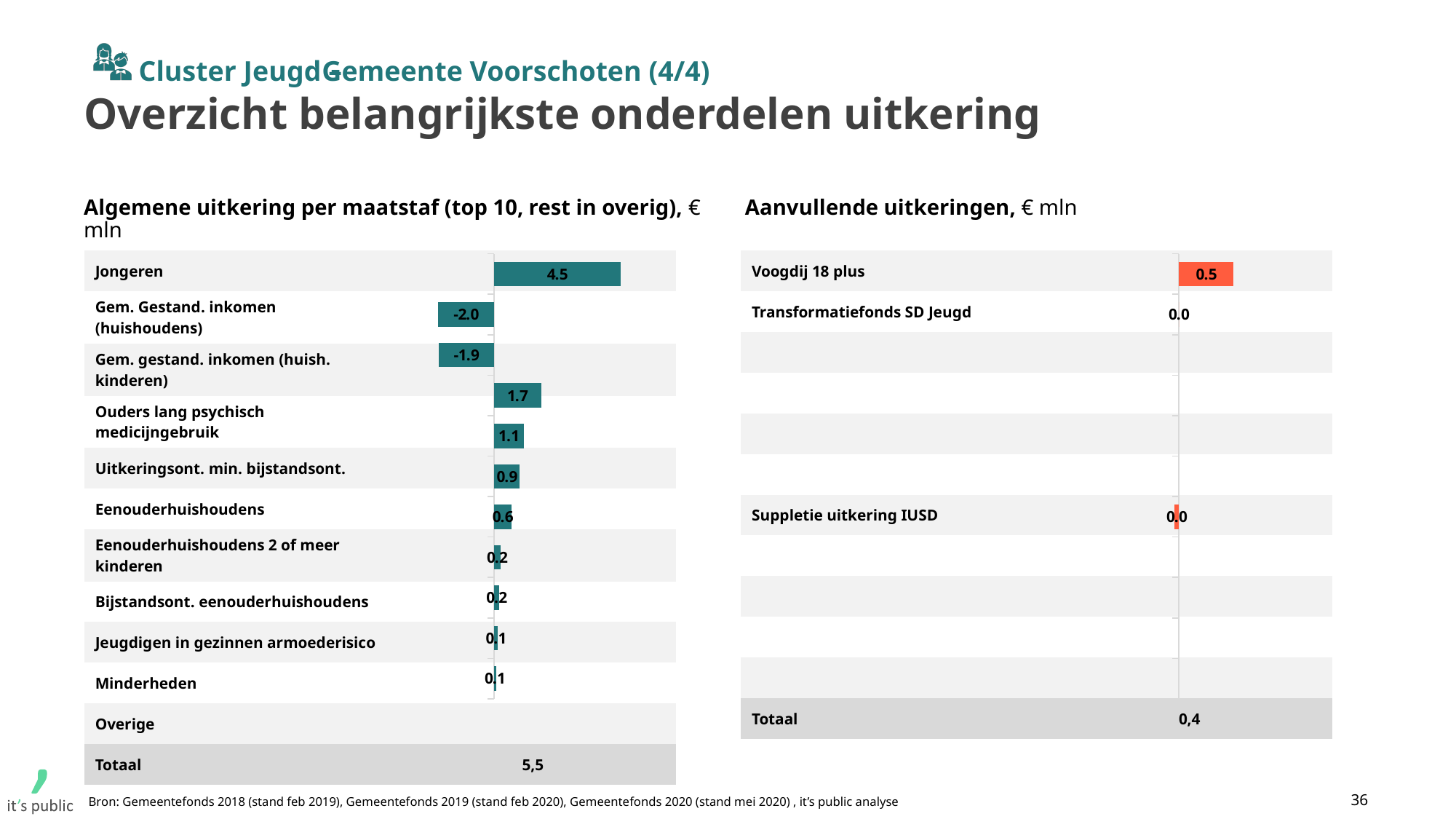
In the left chart 'Algemene uitkering per maatstaf', what is the value for Jongeren? 4.5 In the right chart 'Aanvullende uitkeringen', which category has the highest value? Voogdij 18 plus In the left chart 'Algemene uitkering per maatstaf', what is the value for Gem. Gestand. inkomen (huishoudens)? -2.0 In the right chart 'Aanvullende uitkeringen', what is the value for Transformatiefonds SD Jeugd? 0.0 In the right chart 'Aanvullende uitkeringen', what is the value for Voogdij 18 plus? 0.5 In the left chart 'Algemene uitkering per maatstaf', what is the Totaal shown at the bottom? 5,5 In the right chart 'Aanvullende uitkeringen', what colour is the bar for Voogdij 18 plus? Orange In the left chart 'Algemene uitkering per maatstaf', what is the difference between the value for Jongeren and the value for Gem. Gestand. inkomen (huishoudens)? 6.5 In the right chart 'Aanvullende uitkeringen', what is the Totaal shown at the bottom? 0,4 In the left chart 'Algemene uitkering per maatstaf', which category has the lowest value? Gem. Gestand. inkomen (huishoudens) In the left chart 'Algemene uitkering per maatstaf', which category has the highest value? Jongeren What kind of chart is the left chart 'Algemene uitkering per maatstaf'? Bar chart